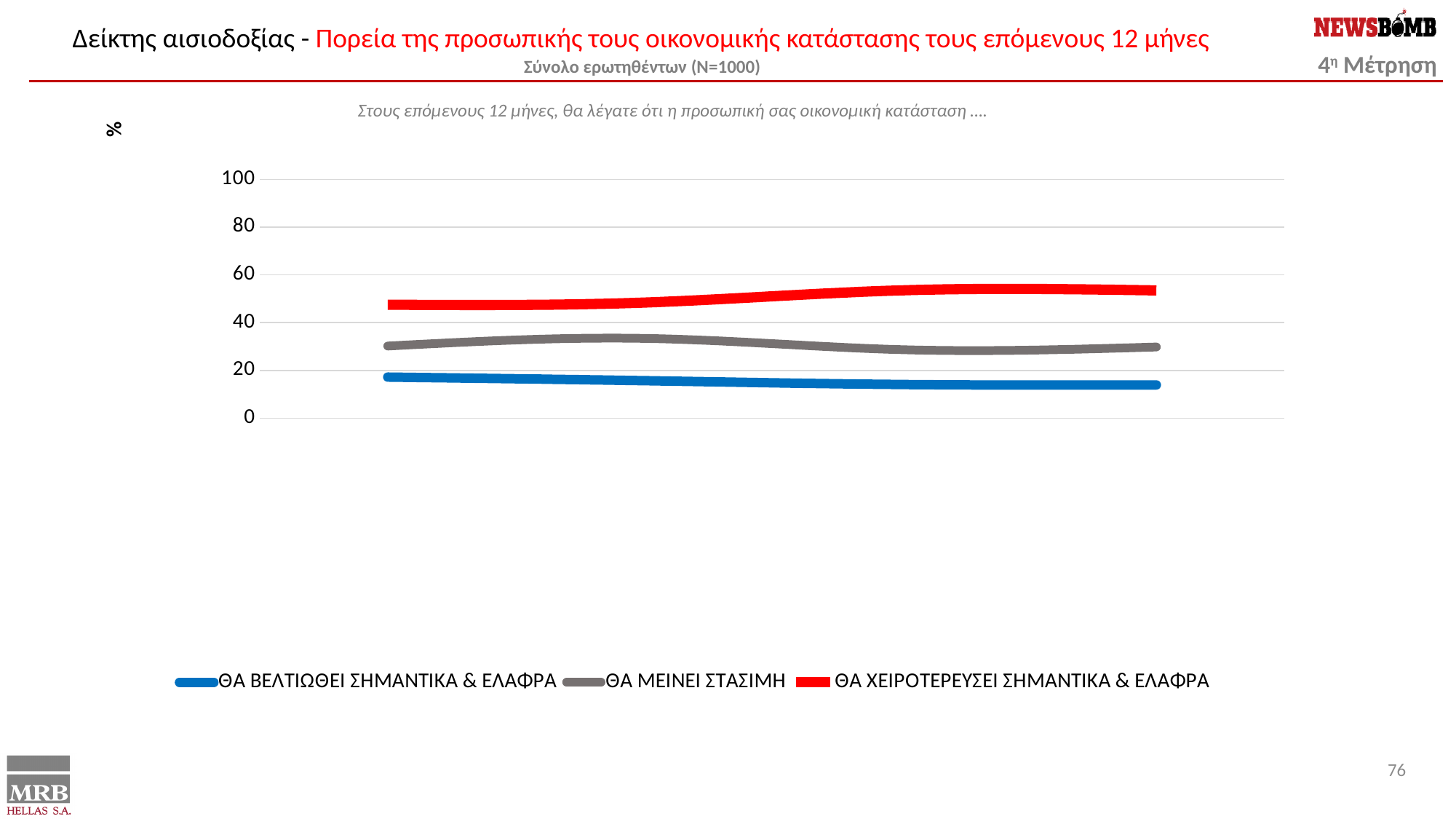
Is the value for ΘΑ ΒΕΛΤΙΩΘΕΙ ΣΗΜΑΝΤΙΚΑ & ΕΛΑΦΡΑ at the end of the line greater or less than 20? less Does the line for ΘΑ ΧΕΙΡΟΤΕΡΕΥΣΕΙ ΣΗΜΑΝΤΙΚΑ & ΕΛΑΦΡΑ rise or fall from left to right overall? rise Does the line for ΘΑ ΒΕΛΤΙΩΘΕΙ ΣΗΜΑΝΤΙΚΑ & ΕΛΑΦΡΑ rise or fall from left to right overall? fall What kind of chart is shown on the slide? line chart Is the value for ΘΑ ΧΕΙΡΟΤΕΡΕΥΣΕΙ ΣΗΜΑΝΤΙΚΑ & ΕΛΑΦΡΑ at the end of the line greater or less than 60? less Is the value for ΘΑ ΧΕΙΡΟΤΕΡΕΥΣΕΙ ΣΗΜΑΝΤΙΚΑ & ΕΛΑΦΡΑ at the start of the line greater or less than 40? greater Which is larger at the end of the lines: ΘΑ ΜΕΙΝΕΙ ΣΤΑΣΙΜΗ or ΘΑ ΒΕΛΤΙΩΘΕΙ ΣΗΜΑΝΤΙΚΑ & ΕΛΑΦΡΑ? ΘΑ ΜΕΙΝΕΙ ΣΤΑΣΙΜΗ Which series has the lowest values throughout the chart? ΘΑ ΒΕΛΤΙΩΘΕΙ ΣΗΜΑΝΤΙΚΑ & ΕΛΑΦΡΑ How many series does the legend list? 3 Which series has the highest values throughout the chart? ΘΑ ΧΕΙΡΟΤΕΡΕΥΣΕΙ ΣΗΜΑΝΤΙΚΑ & ΕΛΑΦΡΑ What colour is the line for ΘΑ ΜΕΙΝΕΙ ΣΤΑΣΙΜΗ? grey